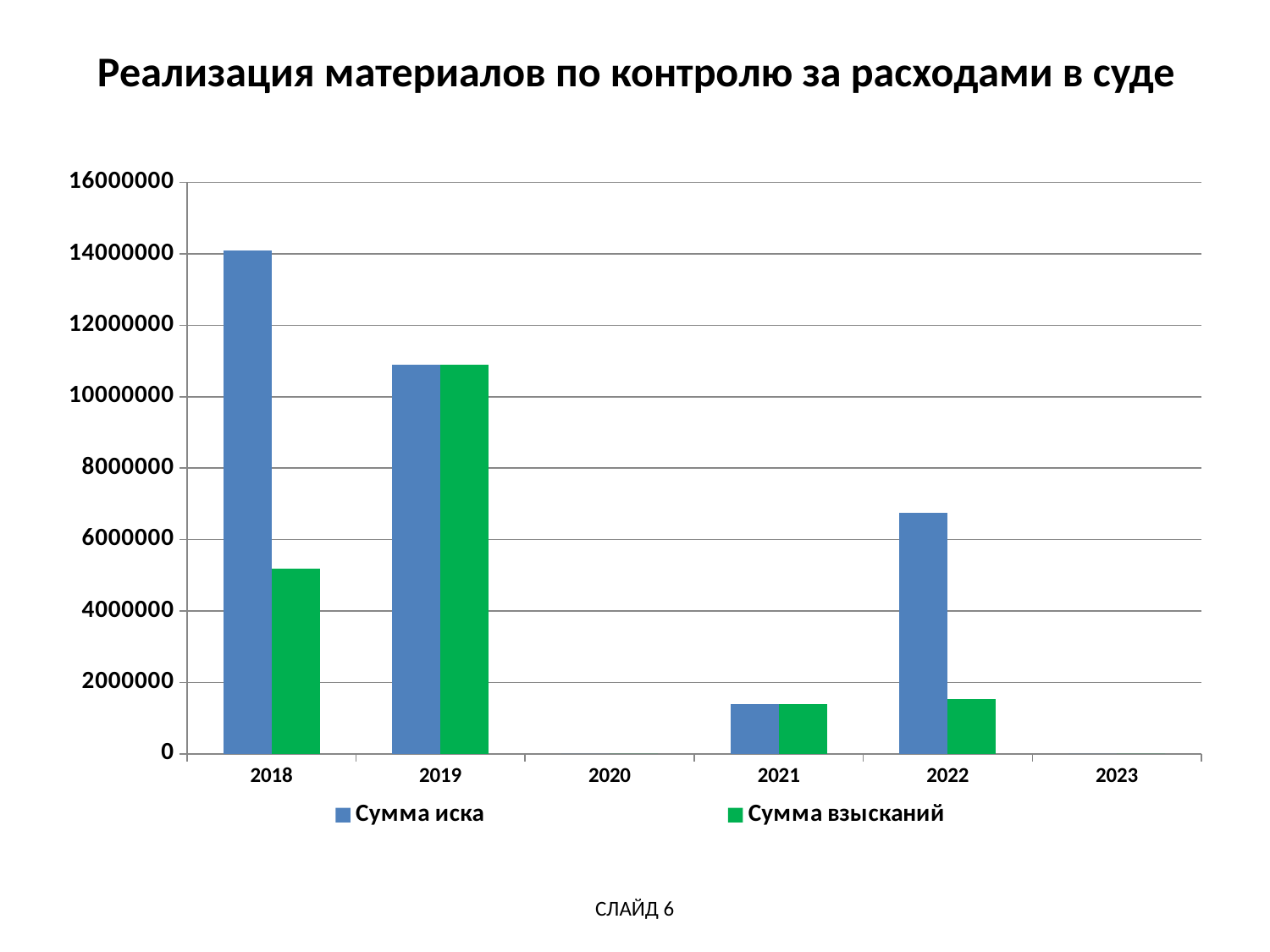
In which year is the value for Сумма взысканий the highest? 2019 How many years are shown on the x axis? 6 What is the title of the chart? Реализация материалов по контролю за расходами в суде What kind of chart is shown on the slide? bar chart In 2018, which is larger: Сумма иска or Сумма взысканий? Сумма иска In which year is the value for Сумма иска the highest? 2018 Which colour represents Сумма взысканий in the legend? green Is the value for Сумма иска in 2022 greater or less than 6000000? greater Is the value for Сумма взысканий in 2018 greater or less than 6000000? less How many series does the legend list? 2 Is the value for Сумма взысканий in 2022 greater or less than 2000000? less